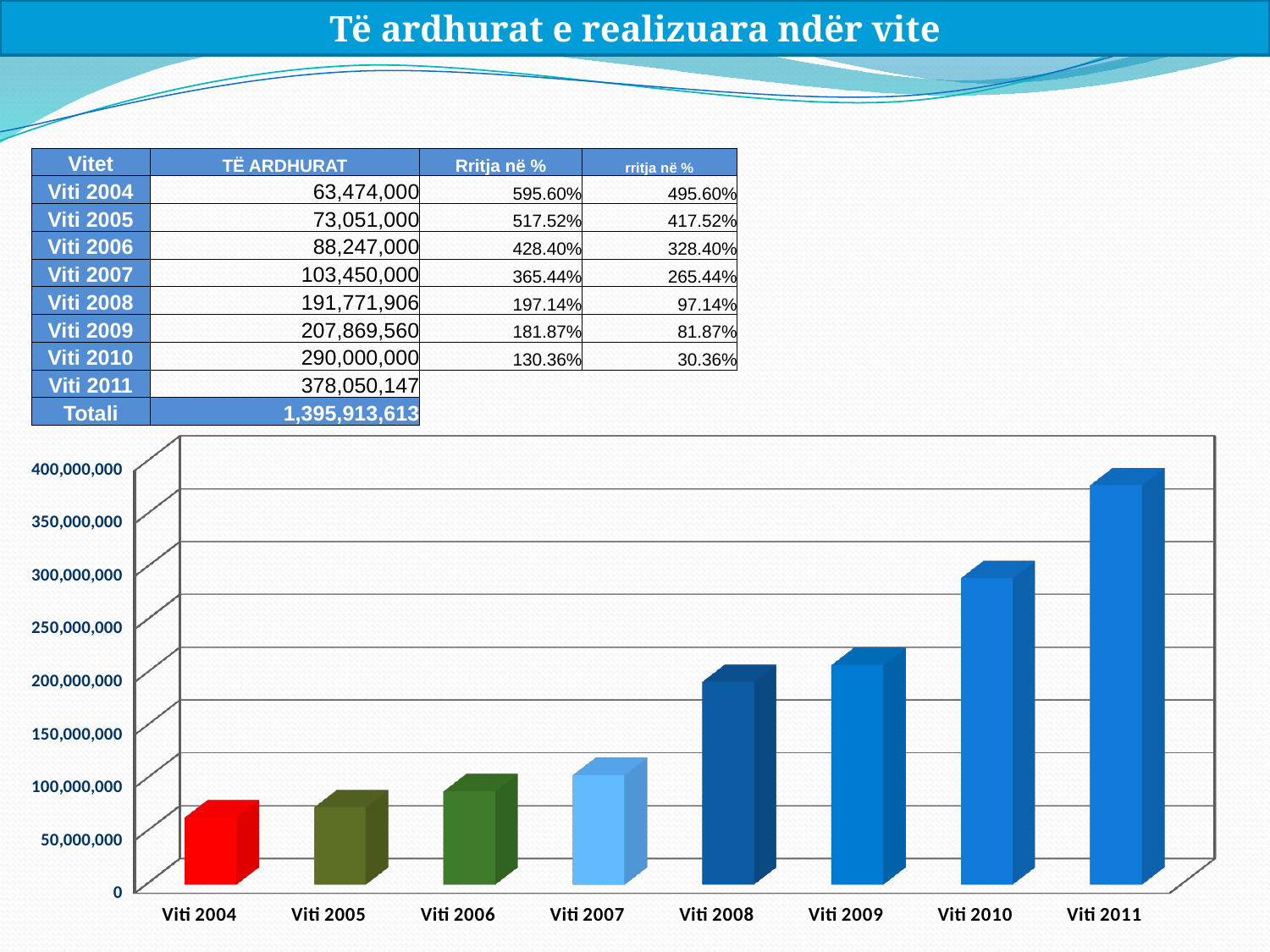
Do the values rise or fall from Viti 2004 to Viti 2011 along the x axis? rise Is the value for Viti 2011 greater or less than 350,000,000? greater Is the value for Viti 2008 greater or less than 150,000,000? greater According to the table on the slide, what is the value of TË ARDHURAT for Viti 2008? 191,771,906 How many years (bars) are shown in the chart? 8 Which year has the highest bar in the chart? Viti 2011 According to the table on the slide, what is the value of TË ARDHURAT for Viti 2011? 378,050,147 Is the value for Viti 2007 greater or less than 150,000,000? less What is the title of the slide? Të ardhurat e realizuara ndër vite Which is larger, the value for Viti 2009 or the value for Viti 2010? Viti 2010 What kind of chart is shown on the slide? bar chart Which year has the lowest bar in the chart? Viti 2004